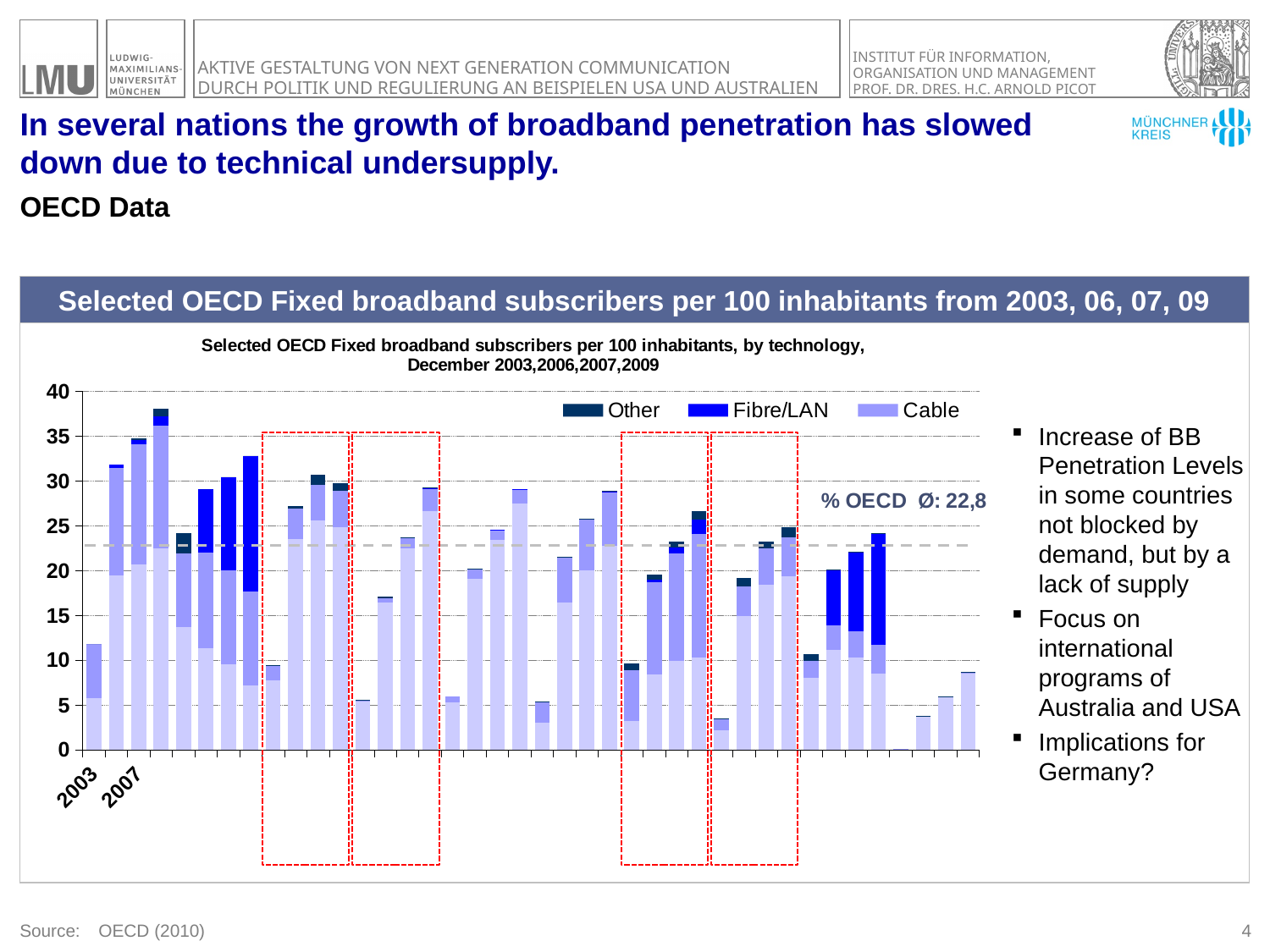
What is the OECD average value shown by the dashed reference line in the chart? 22,8 Is the OECD average line in the chart greater or less than 25? less What are the three series named in the chart's legend? Other, Fibre/LAN, Cable How many series does the chart's legend list? 3 What is the highest value shown on the chart's vertical axis? 40 What is the title printed above the chart's plot area? Selected OECD Fixed broadband subscribers per 100 inhabitants, by technology, December 2003,2006,2007,2009 What kind of chart is shown on the slide? bar chart Is the tallest bar in the chart greater or less than 35? greater